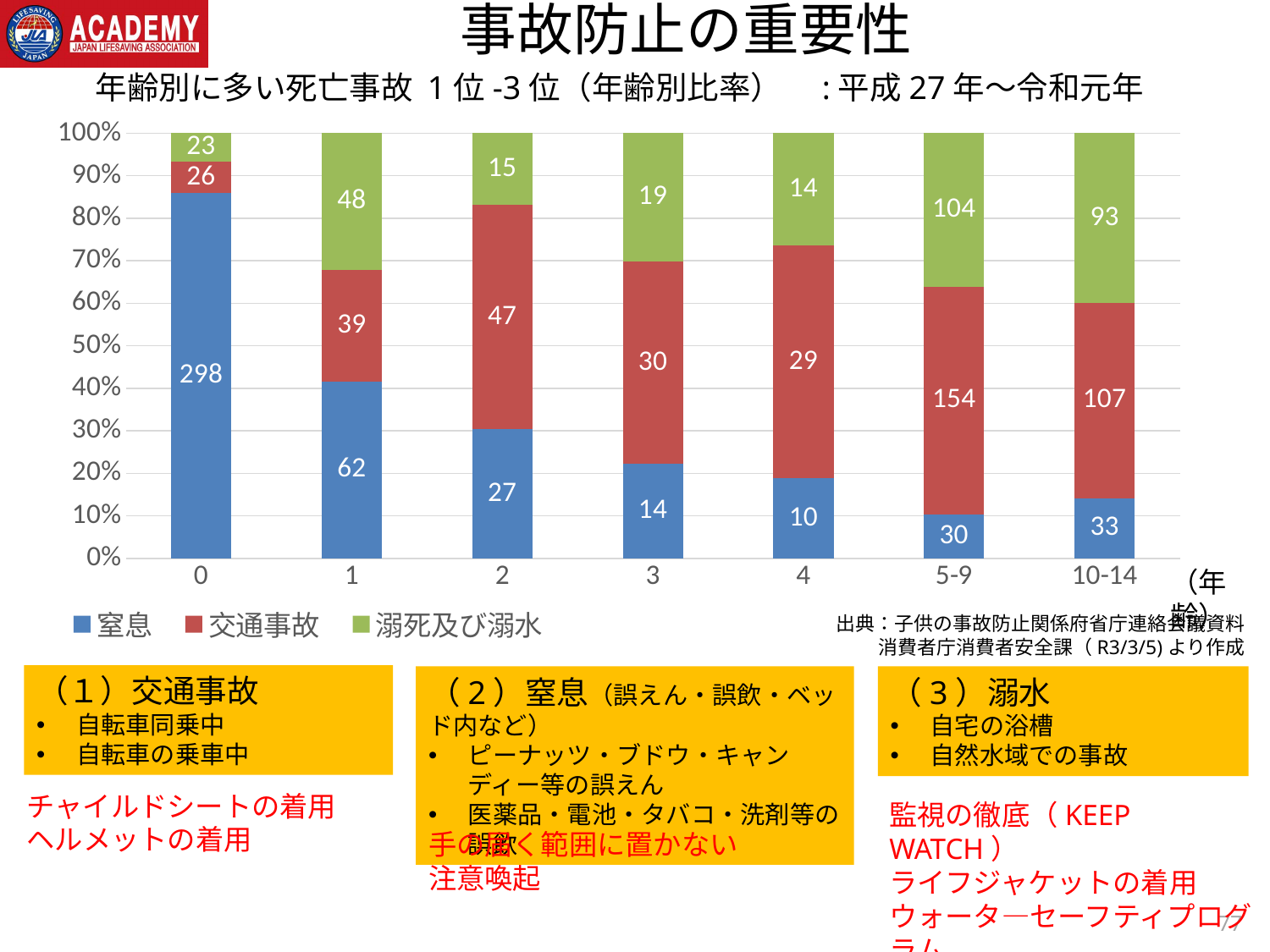
How many series does the legend list? 3 Which colour represents 交通事故 in the chart? Red Which age category has the highest 窒息 value? 0 What is the difference between the 交通事故 values for age categories 5-9 and 10-14? 47 What kind of chart is shown on the slide? 100% stacked bar chart What is the value of 窒息 for age category 0? 298 What is the value of 交通事故 for age category 5-9? 154 Which is larger, the 溺死及び溺水 value for age category 1 or for age category 2? age category 1 What is the value of 溺死及び溺水 for age category 10-14? 93 How many age categories are shown on the x axis? 7 What is the total of the three values in the bar for age category 4? 53 Which age category has the lowest 交通事故 value? 0